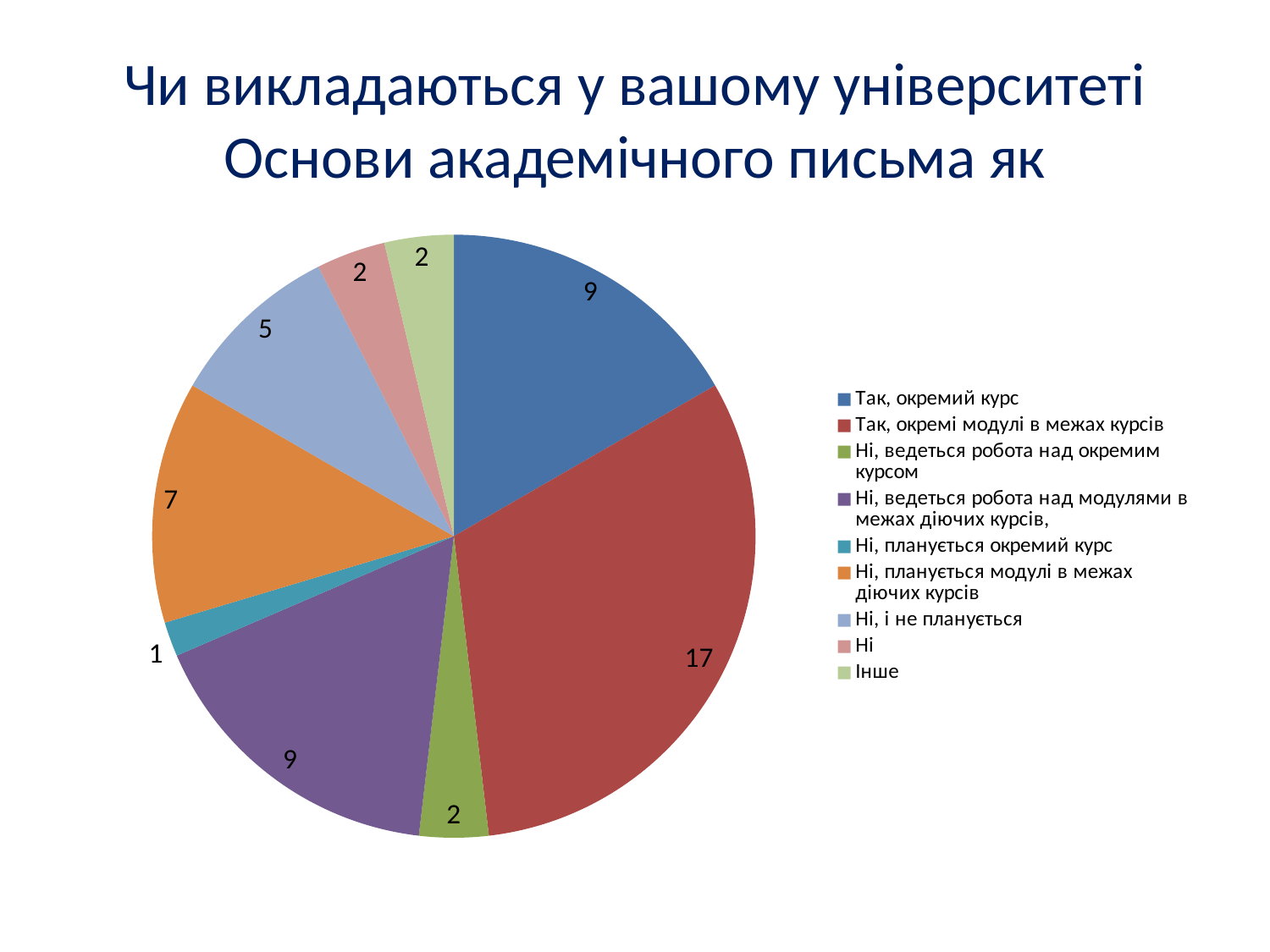
What is the sum of all the values shown in the pie chart? 54 Which category has the smallest slice? Ні, планується окремий курс What kind of chart is shown on the slide? Pie chart What is the value for "Ні, і не планується"? 5 Which is larger: "Ні, планується модулі в межах діючих курсів" or "Ні, і не планується"? Ні, планується модулі в межах діючих курсів What is the value for "Так, окремий курс"? 9 What is the difference between the values for "Так, окремі модулі в межах курсів" and "Так, окремий курс"? 8 What is the value for "Ні, планується модулі в межах діючих курсів"? 7 How many slices does the pie chart have? 9 What is the value for "Так, окремі модулі в межах курсів"? 17 Which category has the largest slice? Так, окремі модулі в межах курсів What is the title of the chart on the slide? Чи викладаються у вашому університеті Основи академічного письма як